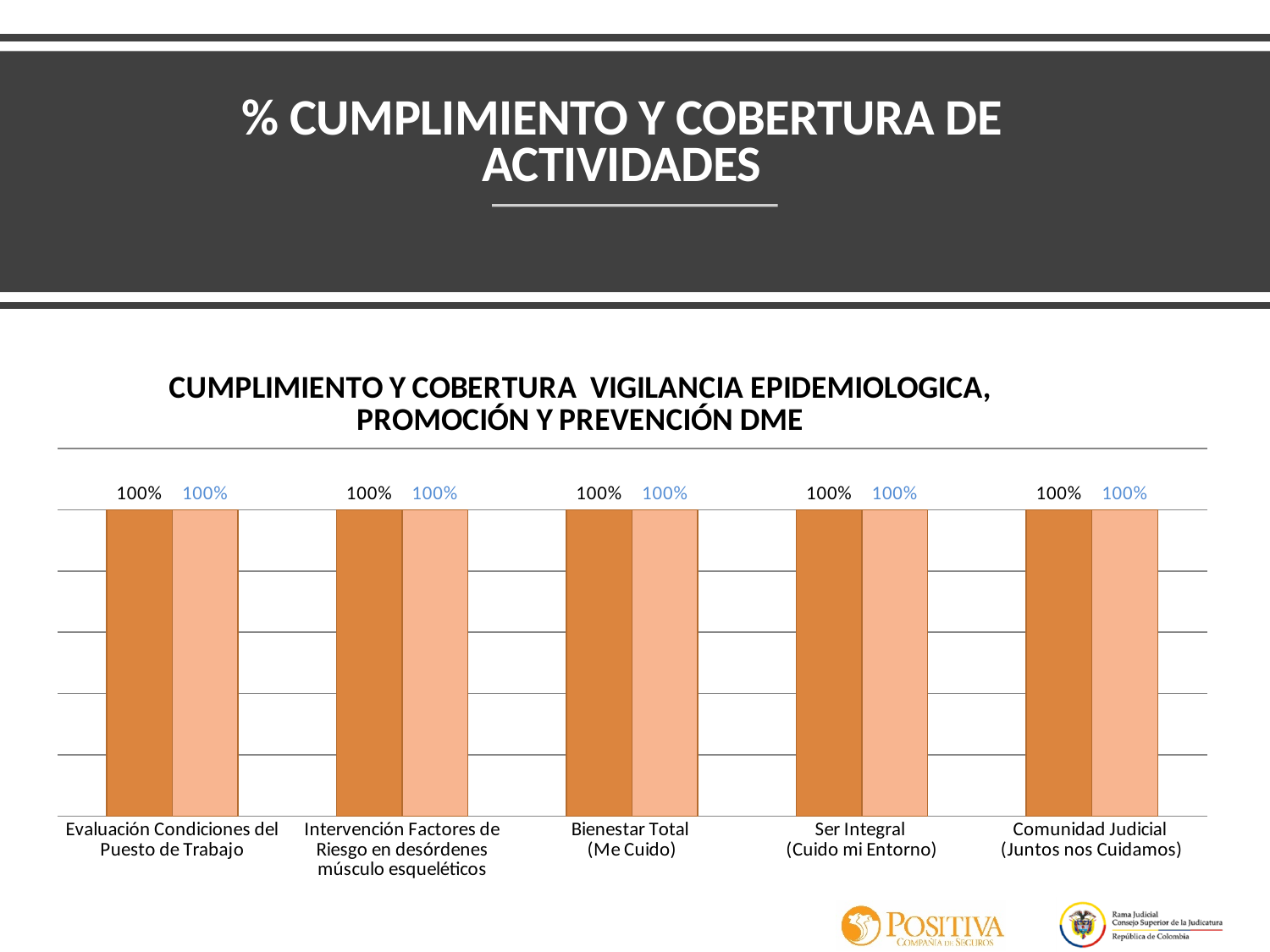
What is the difference between the dark orange bar for Bienestar Total (Me Cuido) and the dark orange bar for Comunidad Judicial (Juntos nos Cuidamos)? 0% How many categories are shown along the x axis of the chart? 5 What is the value of the dark orange bar for Evaluación Condiciones del Puesto de Trabajo? 100% How many bars are plotted for each category in the chart? 2 What is the value of the dark orange bar for Intervención Factores de Riesgo en desórdenes músculo esqueléticos? 100% What is the value of the light orange bar for Comunidad Judicial (Juntos nos Cuidamos)? 100% What is the difference between the dark orange and light orange bars for Ser Integral (Cuido mi Entorno)? 0% What kind of chart is shown on the slide? bar chart Do the values of the dark orange bars rise, fall, or stay flat across the categories from left to right? stay flat What is the value of the light orange bar for Ser Integral (Cuido mi Entorno)? 100% What is the title of the chart? CUMPLIMIENTO Y COBERTURA VIGILANCIA EPIDEMIOLOGICA, PROMOCIÓN Y PREVENCIÓN DME What is the value of the dark orange bar for Bienestar Total (Me Cuido)? 100%